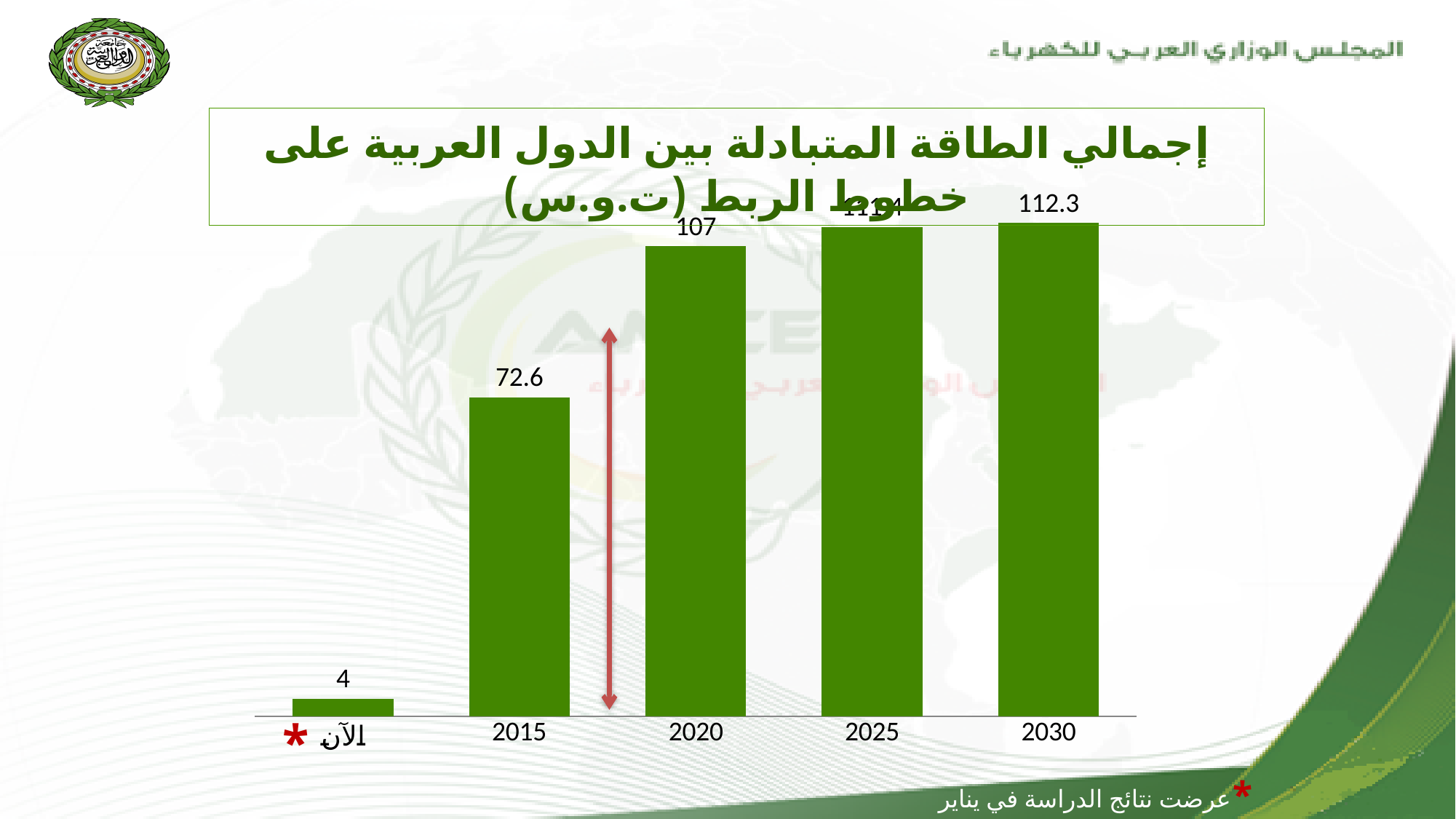
What is the difference between the values for 2020 and 2015? 34.4 What is the value for 2020? 107 Which is larger, the value for 2020 or the value for 2015? 2020 What is the difference between the values for 2030 and 2020? 5.3 How many categories are shown on the x axis? 5 What is the difference between the values for 2015 and الآن? 68.6 What is the value for 2030? 112.3 Do the values rise or fall from الآن to 2030? rise What is the value for الآن (now)? 4 What is the value for 2015? 72.6 What kind of chart is shown on the slide? bar chart Which category has the lowest value? الآن